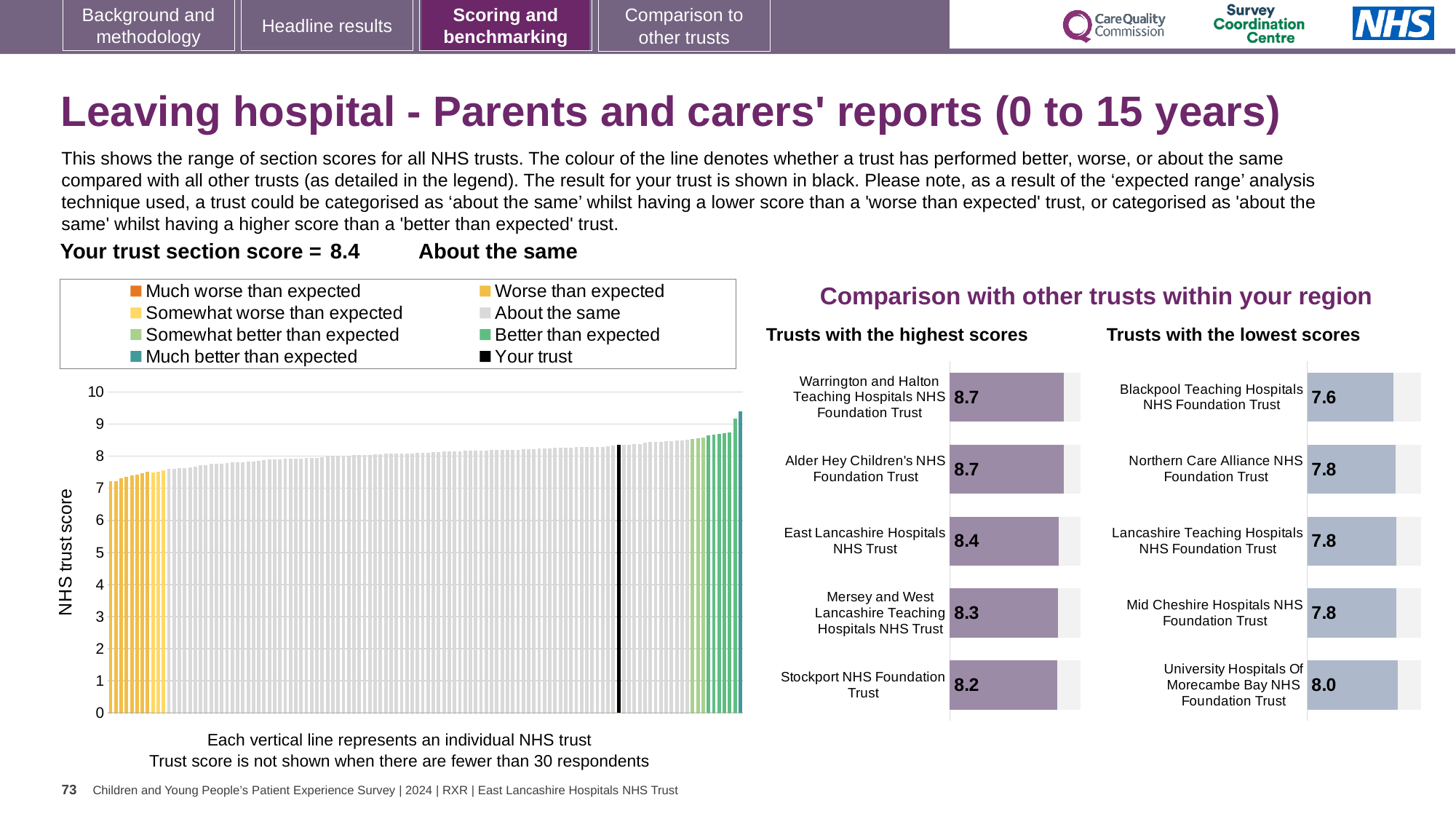
In the 'Trusts with the lowest scores' chart, which trust has the highest score? University Hospitals Of Morecambe Bay NHS Foundation Trust In the 'Trusts with the highest scores' chart, which trust has the lowest score? Stockport NHS Foundation Trust In the 'Trusts with the highest scores' chart, what is the score for Stockport NHS Foundation Trust? 8.2 How many entries does the legend of the main NHS trust score chart list? 8 In the 'Trusts with the lowest scores' chart, which is larger: the score for Blackpool Teaching Hospitals NHS Foundation Trust or the score for Mid Cheshire Hospitals NHS Foundation Trust? Mid Cheshire Hospitals NHS Foundation Trust In the 'Trusts with the lowest scores' chart, what is the score for Blackpool Teaching Hospitals NHS Foundation Trust? 7.6 In the main NHS trust score chart on the left, do the values rise or fall from left to right? rise How many trusts are shown in the 'Trusts with the lowest scores' chart? 5 In the 'Trusts with the highest scores' chart, what is the difference between the scores of Warrington and Halton Teaching Hospitals NHS Foundation Trust and Stockport NHS Foundation Trust? 0.5 What kind of chart is the 'Trusts with the highest scores' chart? bar chart In the main NHS trust score chart on the left, is the value of the tallest bar greater or less than 9? greater In the 'Trusts with the highest scores' chart, what is the score for Warrington and Halton Teaching Hospitals NHS Foundation Trust? 8.7